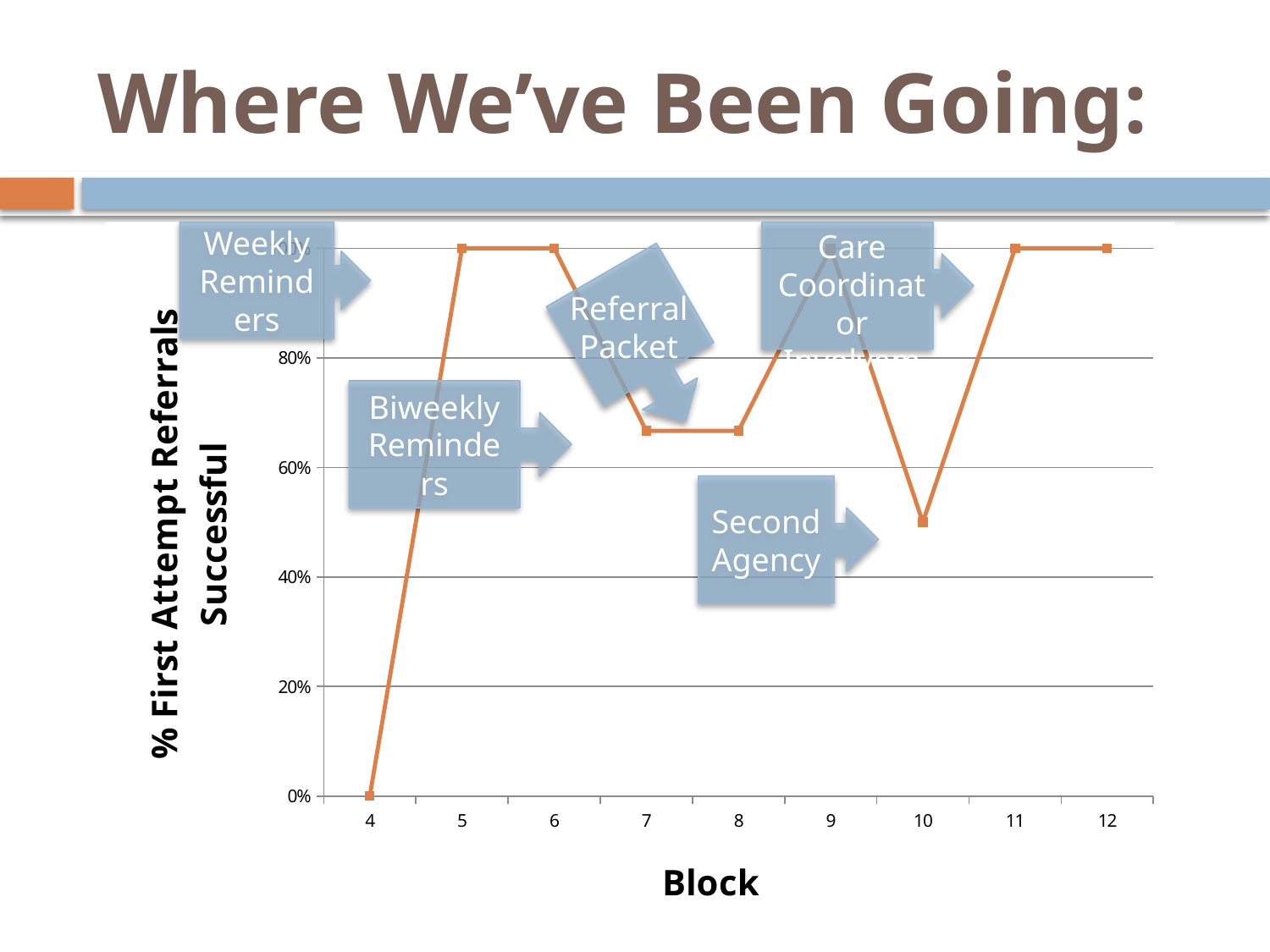
Which is larger, the value for Block 7 or the value for Block 10? Block 7 Is the value for Block 10 greater or less than 40%? greater What is the value for Block 4? 0% Is the value for Block 10 greater or less than 60%? less Does the value rise or fall from Block 9 to Block 10? fall How many blocks are plotted on the x axis? 9 Is the value for Block 5 greater or less than 80%? greater What kind of chart is shown on the slide? line chart Which block has the lowest value? 4 What is the title of the x axis? Block